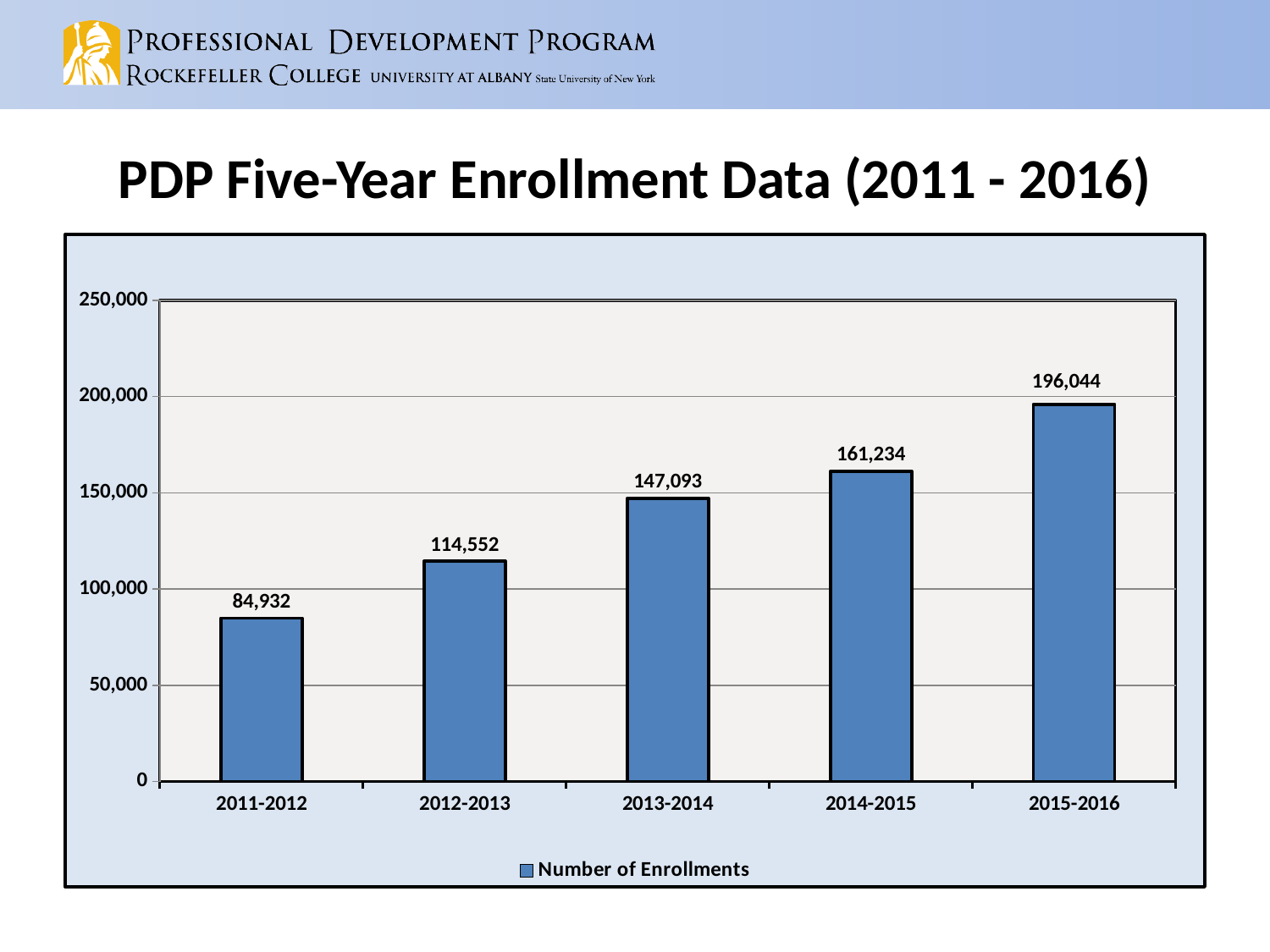
What is the number of enrollments for 2011-2012? 84,932 What is the number of enrollments for 2015-2016? 196,044 Which year has the lowest number of enrollments? 2011-2012 Is the value for 2012-2013 greater or less than 100,000? greater How many academic years are shown on the chart? 5 What is the difference in enrollments between 2015-2016 and 2011-2012? 111,112 Which has more enrollments, 2012-2013 or 2014-2015? 2014-2015 What is the difference in enrollments between 2014-2015 and 2013-2014? 14,141 What is the number of enrollments for 2013-2014? 147,093 Which year has the highest number of enrollments? 2015-2016 What kind of chart is shown on the slide? Bar chart Do enrollments rise or fall from 2011-2012 to 2015-2016? Rise